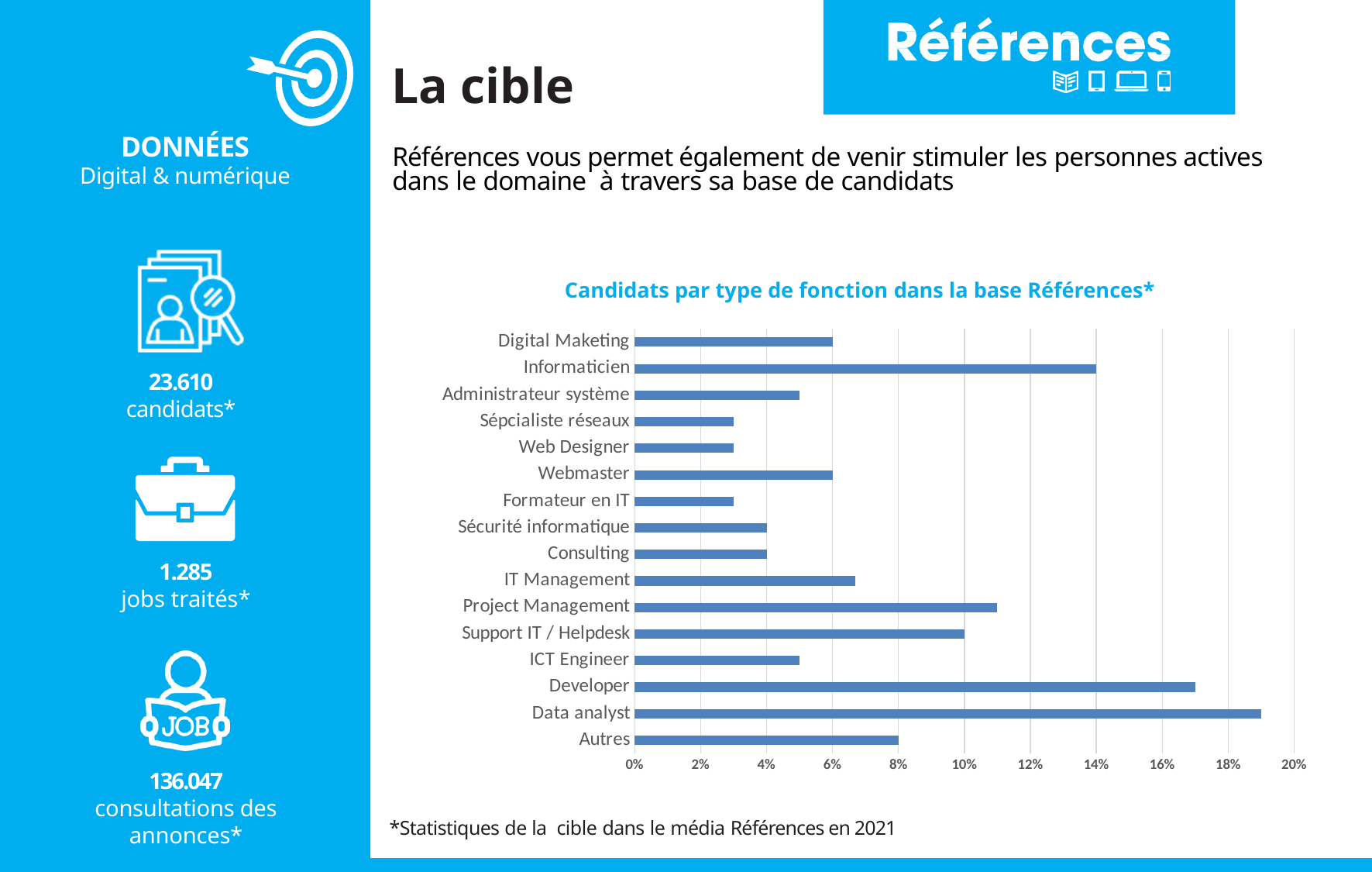
What is the value for Autres? 8% What is the value for Support IT / Helpdesk? 10% Which function type has the highest share of candidates? Data analyst Is the value for Project Management greater or less than 10%? greater What kind of chart is shown on the slide? bar chart Is the value for Developer greater or less than 16%? greater Is the value for Sépcialiste réseaux greater or less than 4%? less Which is larger, the value for Developer or the value for Informaticien? Developer How many function types (categories) are plotted in the chart? 16 Which is larger, the value for Project Management or the value for Digital Maketing? Project Management What is the value for Informaticien? 14% What is the title of the chart? Candidats par type de fonction dans la base Références*